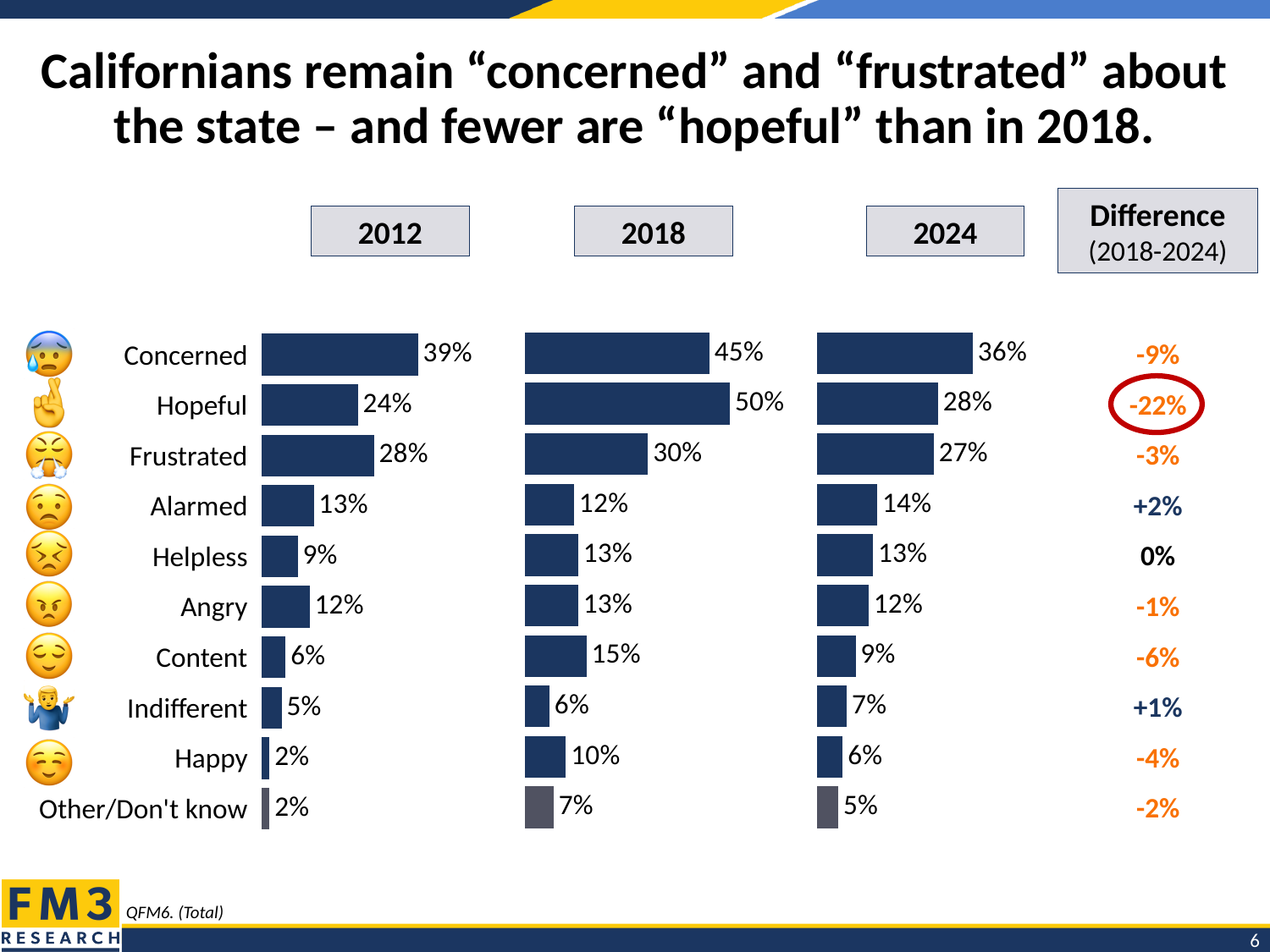
In the 2018 chart, which category has the highest value? Hopeful In the 2012 chart, which is larger: the value for "Frustrated" or the value for "Hopeful"? Frustrated What type of chart is used to show the 2018 data? Bar chart Which category's difference value (2018-2024) is circled in red on the slide? Hopeful (-22%) In the 2012 chart, which category has the lowest value among the named emotions (excluding Other/Don't know)? Happy How many categories are shown in each of the bar charts? 10 In the 2024 chart, what is the value for "Frustrated"? 27% In the 2024 chart, which category has the highest value? Concerned What is the difference between the "Hopeful" values in the 2018 chart and the 2024 chart? 22% In the 2024 chart, which is larger: the value for "Content" or the value for "Happy"? Content In the 2018 chart, what is the value for "Hopeful"? 50% In the 2012 chart, what percentage of Californians said they were "Concerned"? 39%